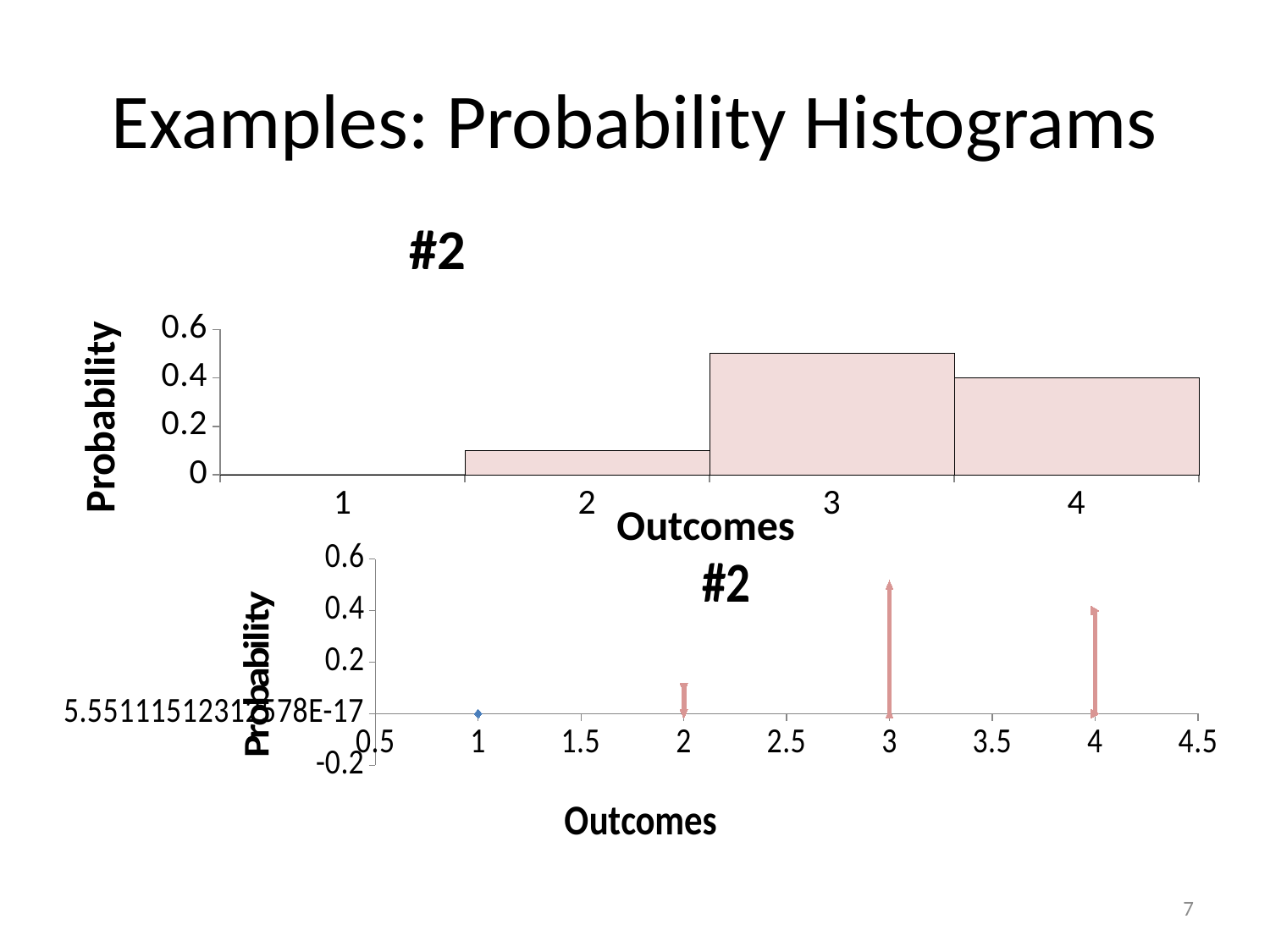
In the top chart, how many outcome categories are shown on the x axis? 4 In the bottom chart, is the probability for outcome 2 greater or less than 0.2? less What is the title of the bottom chart? #2 In the top chart, is the probability for outcome 2 greater or less than 0.2? less In the top chart, which outcome has the highest probability? 3 In the top chart, which outcome has the lowest probability? 1 In the top chart, what is the probability for outcome 4? 0.4 In the bottom chart, which outcome has the highest probability? 3 In the top chart, which outcome has the larger probability, 3 or 4? 3 What kind of chart is the top chart on the slide? bar chart In the top chart, is the probability for outcome 3 greater or less than 0.4? greater What is the x-axis title of the top chart? Outcomes